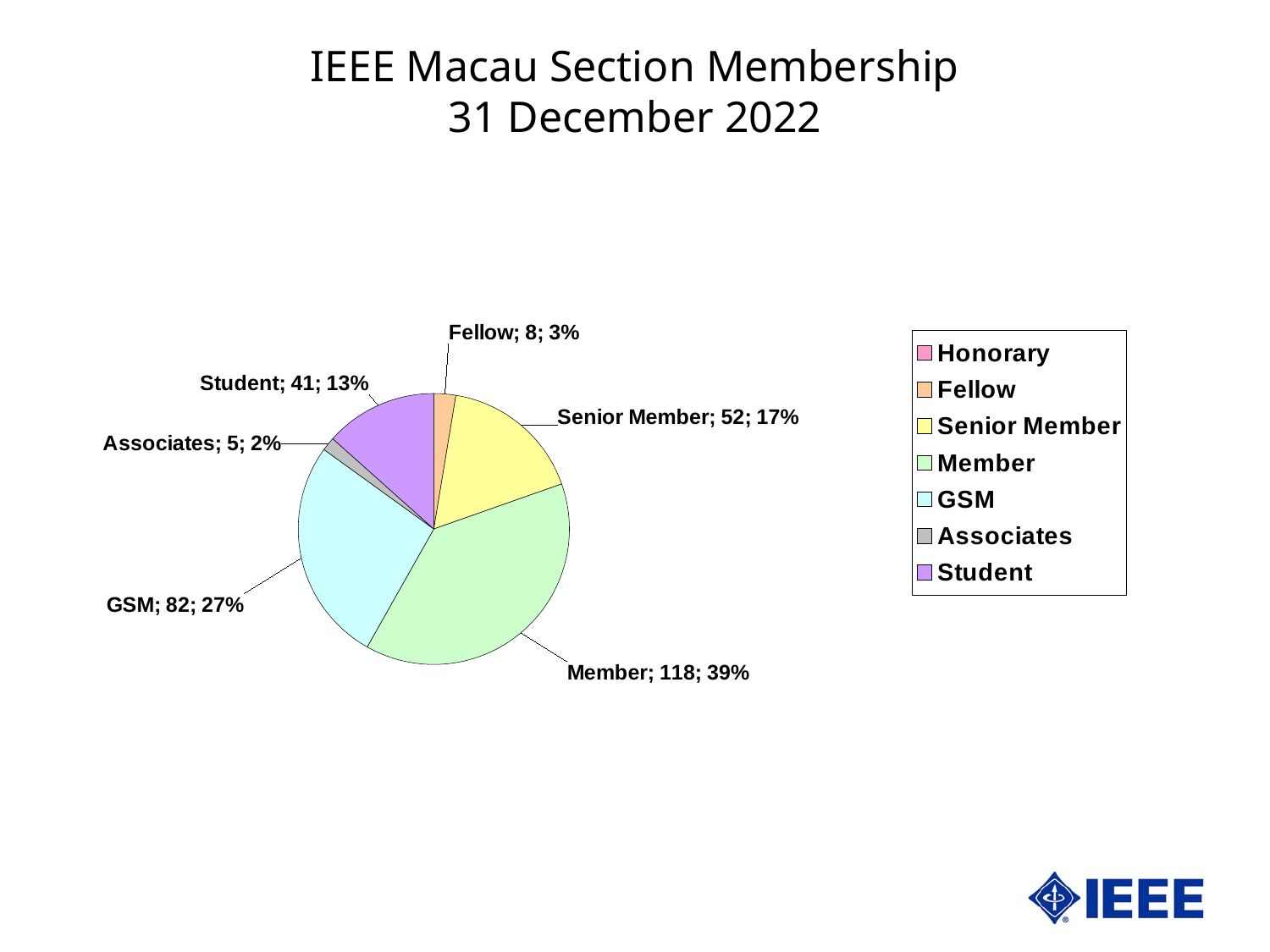
What kind of chart is shown on the slide? pie chart How many members are in the Member category? 118 What is the title of the chart? IEEE Macau Section Membership 31 December 2022 Which category has the largest slice of the pie? Member Which is larger, the Student count or the Senior Member count? Senior Member What percentage share does the Fellow slice have? 3% What is the difference between the Member count and the GSM count? 36 What is the value for Senior Member? 52 What share of the pie does GSM represent? 27% What colour is the Member slice in the legend? light green How many entries does the legend list? 7 Which labelled category has the smallest slice of the pie? Associates